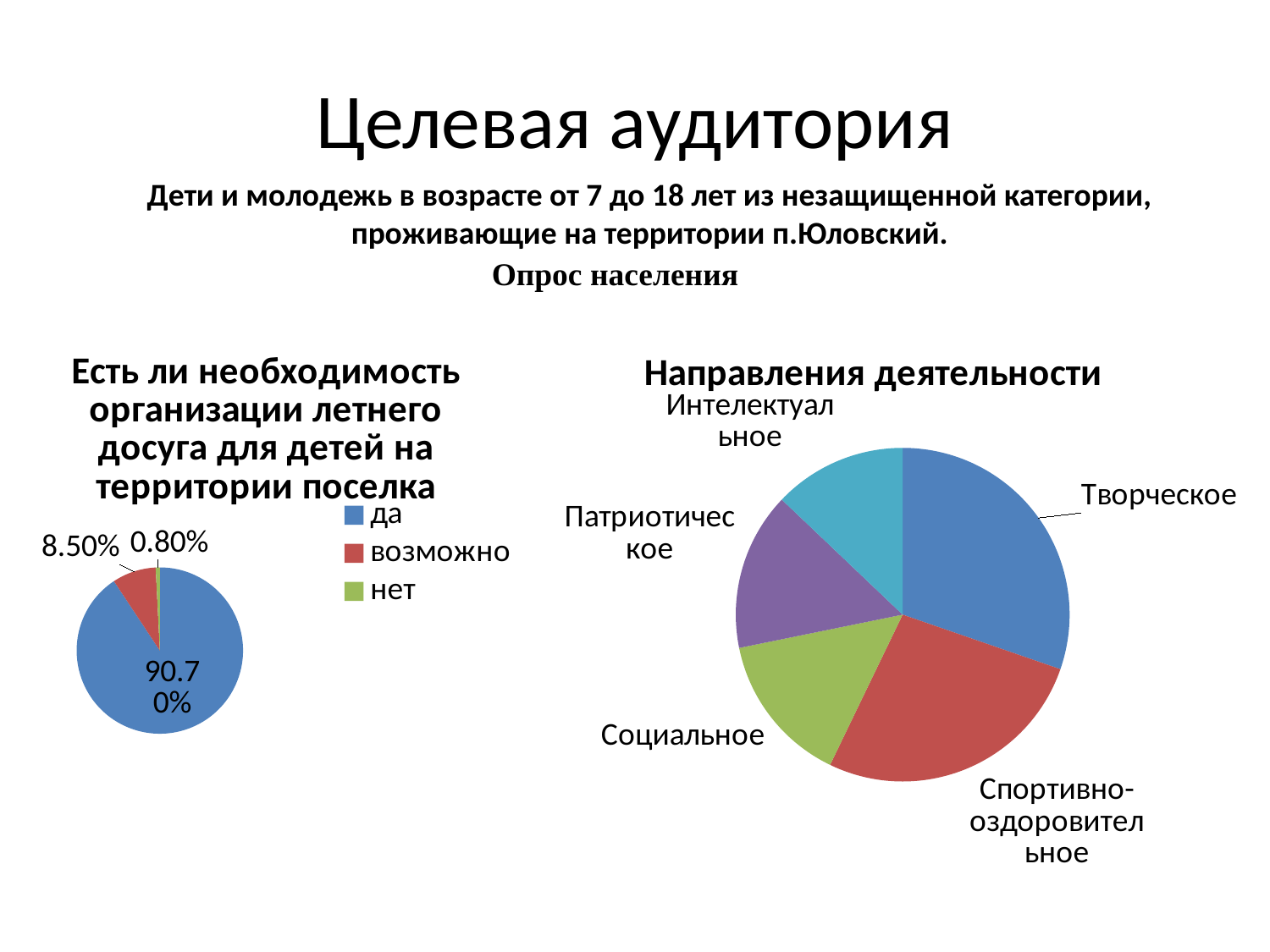
What kind of chart is the right chart (Направления деятельности)? Pie chart In the left chart (Есть ли необходимость организации летнего досуга для детей на территории поселка), what is the difference between the shares for 'возможно' and 'нет'? 7.70% How many categories does the right chart (Направления деятельности) show? 5 In the left chart (Есть ли необходимость организации летнего досуга для детей на территории поселка), what is the difference between the shares for 'да' and 'возможно'? 82.20% In the left chart (Есть ли необходимость организации летнего досуга для детей на территории поселка), what percentage is shown for 'возможно'? 8.50% In the left chart (Есть ли необходимость организации летнего досуга для детей на территории поселка), what percentage is shown for 'да'? 90.70% In the left chart (Есть ли необходимость организации летнего досуга для детей на территории поселка), which is larger: the share for 'возможно' or for 'нет'? возможно How many categories does the left chart (Есть ли необходимость организации летнего досуга для детей на территории поселка) show? 3 In the left chart (Есть ли необходимость организации летнего досуга для детей на территории поселка), which answer has the smallest share? нет In the left chart (Есть ли необходимость организации летнего досуга для детей на территории поселка), what percentage is shown for 'нет'? 0.80% What is the title of the right chart on the slide? Направления деятельности In the left chart (Есть ли необходимость организации летнего досуга для детей на территории поселка), which answer has the largest share? да